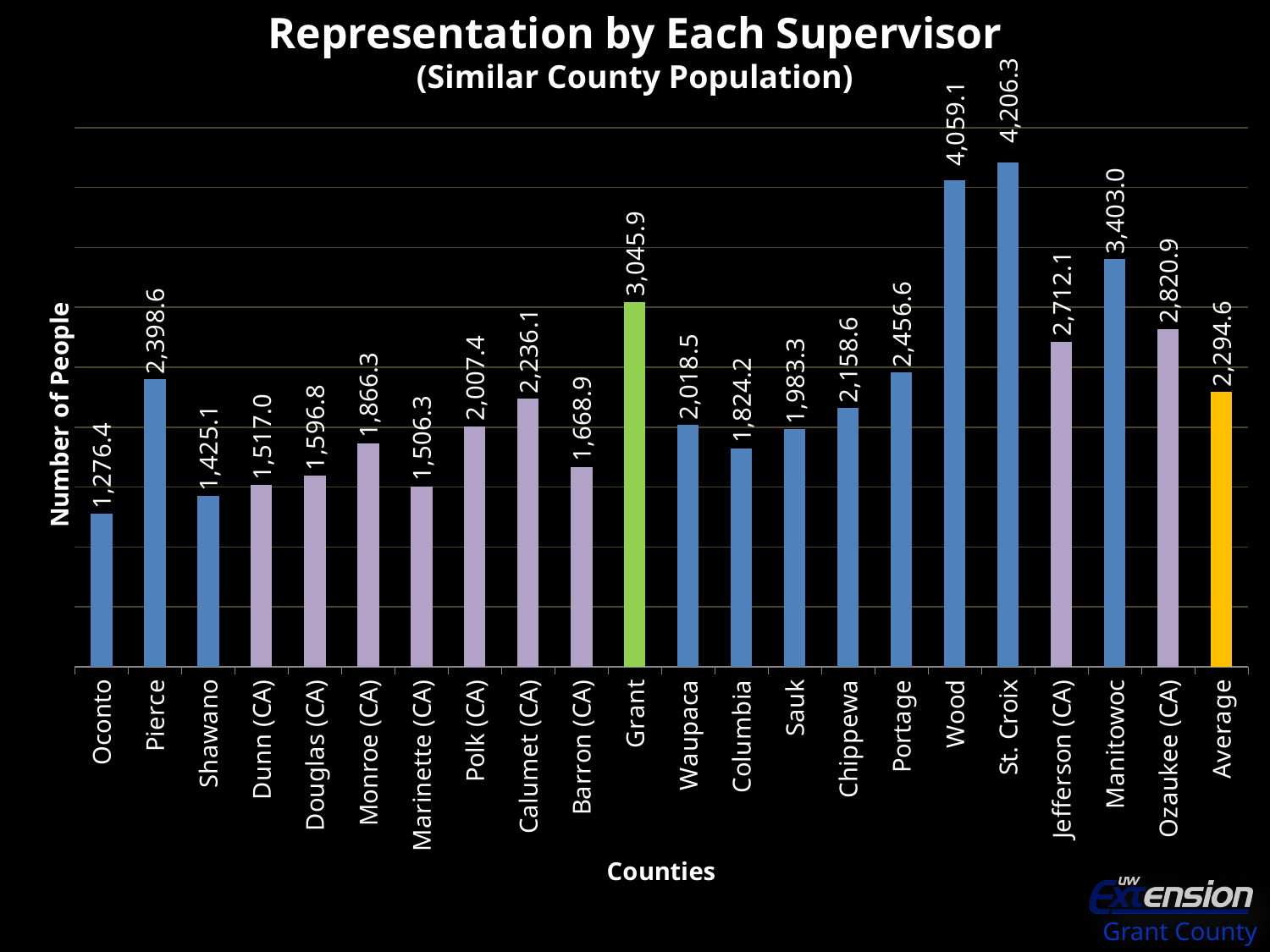
What is the value for Marinette (CA)? 1,506.3 Which county has the highest number of people per supervisor? St. Croix Which has a larger value, Manitowoc or Ozaukee (CA)? Manitowoc How much higher is Grant's value than the Average value? 751.3 What is the difference between the values for St. Croix and Wood? 147.2 What is the value shown for the Average bar? 2,294.6 Which county has the lowest number of people per supervisor? Oconto What is the label of the y axis? Number of People What is the number of people represented per supervisor in Grant County? 3,045.9 What type of chart is shown on the slide? Bar chart What is the value for St. Croix? 4,206.3 How many bars are plotted on the chart, including the Average bar? 22